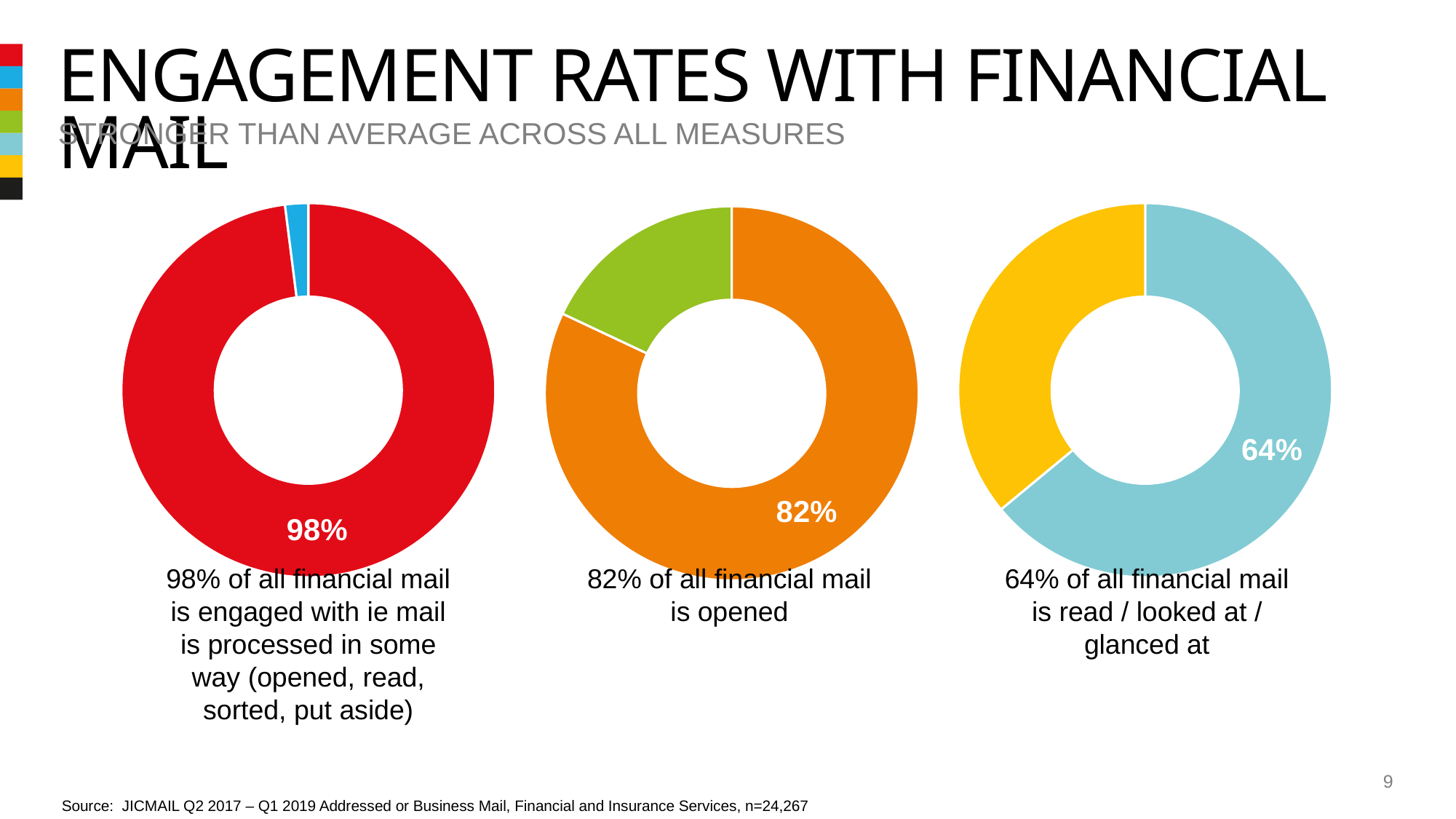
On the right donut chart, what value is printed on the light blue slice? 64% On the left donut chart, what value is printed on the red slice? 98% What kind of chart is used for each of the three charts on the slide? Donut (pie) chart According to the caption under the middle donut chart, what share of all financial mail is opened? 82% On the middle donut chart, what value is printed on the orange slice? 82% Is the labelled value on the middle donut chart larger or smaller than the labelled value on the right donut chart? Larger What is the difference between the labelled value on the left donut chart and the labelled value on the middle donut chart? 16 percentage points Which of the three donut charts shows the highest labelled percentage? The left chart (98%) Which of the three donut charts shows the lowest labelled percentage? The right chart (64%) How many donut charts are shown on the slide? 3 How many slices does the middle donut chart have? 2 What colour is the larger slice of the right donut chart? Light blue